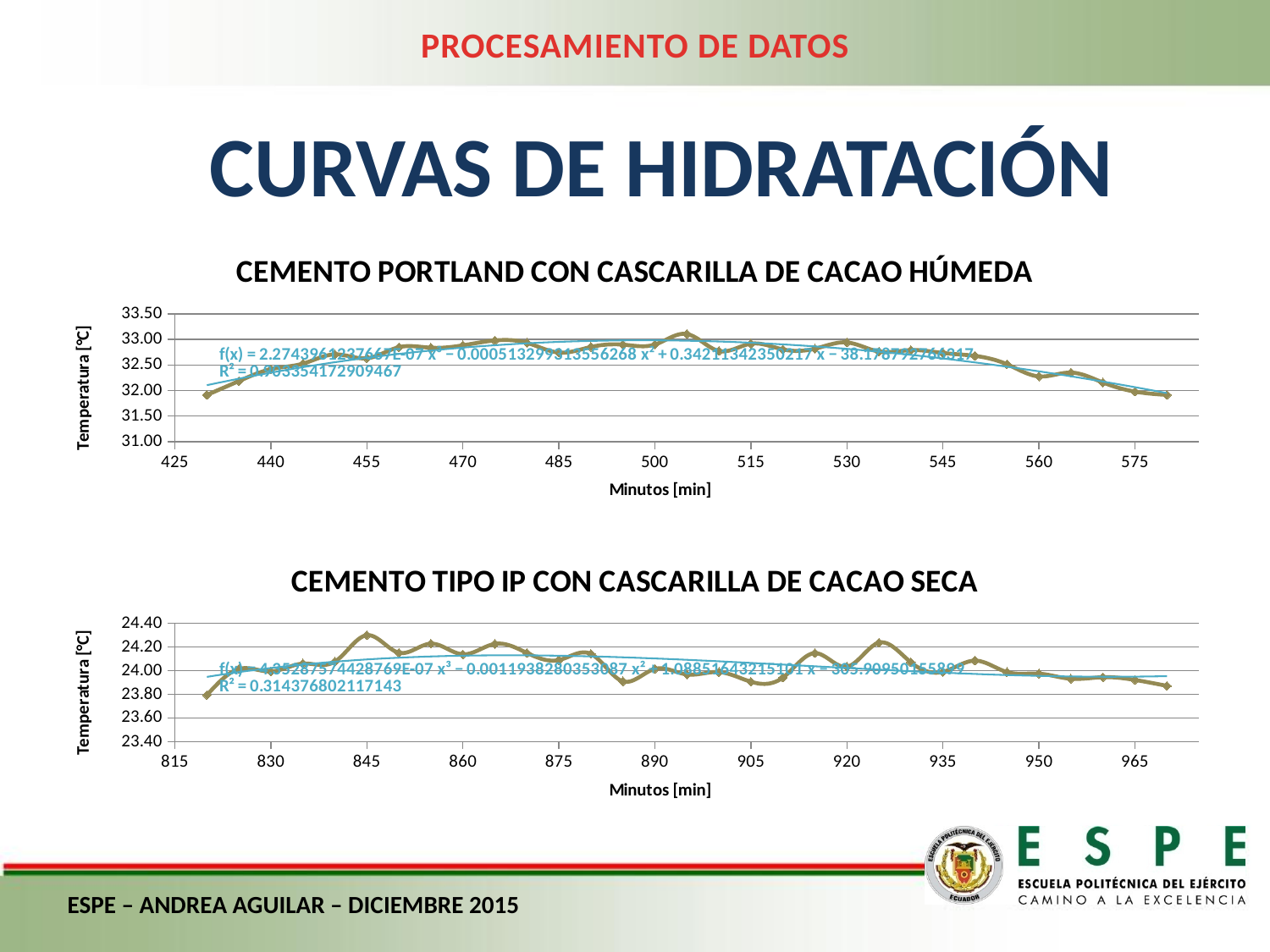
What kind of chart is the 'CEMENTO PORTLAND CON CASCARILLA DE CACAO HÚMEDA' chart? line chart In the 'CEMENTO TIPO IP CON CASCARILLA DE CACAO SECA' chart, is the temperature at the last plotted point (around 970 minutes) greater or less than 24.00? less In the 'CEMENTO TIPO IP CON CASCARILLA DE CACAO SECA' chart, is the temperature at 845 minutes greater or less than 24.20? greater In the 'CEMENTO PORTLAND CON CASCARILLA DE CACAO HÚMEDA' chart, which is higher: the temperature at 500 minutes or the temperature at 575 minutes? 500 minutes In the 'CEMENTO PORTLAND CON CASCARILLA DE CACAO HÚMEDA' chart, is the highest plotted temperature greater or less than 33.00? greater How many charts are shown on the slide? 2 In the 'CEMENTO PORTLAND CON CASCARILLA DE CACAO HÚMEDA' chart, do the temperature values rise or fall between 545 and 575 minutes? fall In the 'CEMENTO TIPO IP CON CASCARILLA DE CACAO SECA' chart, do the temperature values rise or fall between 815 and 845 minutes? rise What is the y-axis title of the 'CEMENTO PORTLAND CON CASCARILLA DE CACAO HÚMEDA' chart? Temperatura [°C] What is the x-axis title of the 'CEMENTO TIPO IP CON CASCARILLA DE CACAO SECA' chart? Minutos [min] In the 'CEMENTO TIPO IP CON CASCARILLA DE CACAO SECA' chart, which is higher: the temperature at 845 minutes or the temperature at 965 minutes? 845 minutes